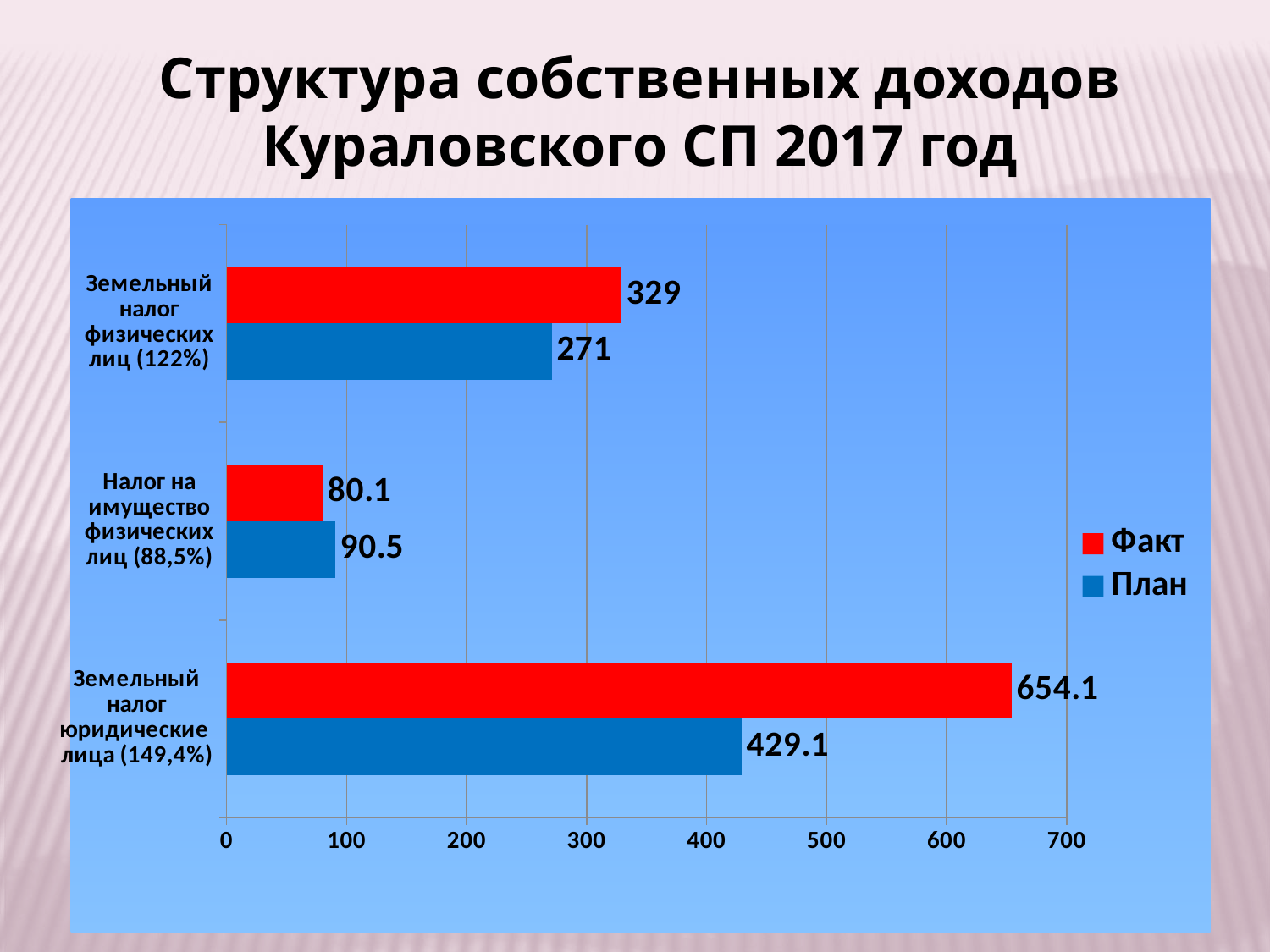
What is the План value for Земельный налог юридические лица (149,4%)? 429.1 How many series does the legend list? 2 Which category has the highest Факт value? Земельный налог юридические лица (149,4%) What kind of chart is shown on the slide? Bar chart What is the Факт value for Земельный налог физических лиц (122%)? 329 What is the Факт value for Налог на имущество физических лиц (88,5%)? 80.1 What is the План value for Налог на имущество физических лиц (88,5%)? 90.5 For Налог на имущество физических лиц (88,5%), which is larger, Факт or План? План Which category has the lowest План value? Налог на имущество физических лиц (88,5%) What is the difference between the Факт and План values for Земельный налог физических лиц (122%)? 58 How many categories are shown on the chart? 3 What is the difference between the Факт and План values for Земельный налог юридические лица (149,4%)? 225